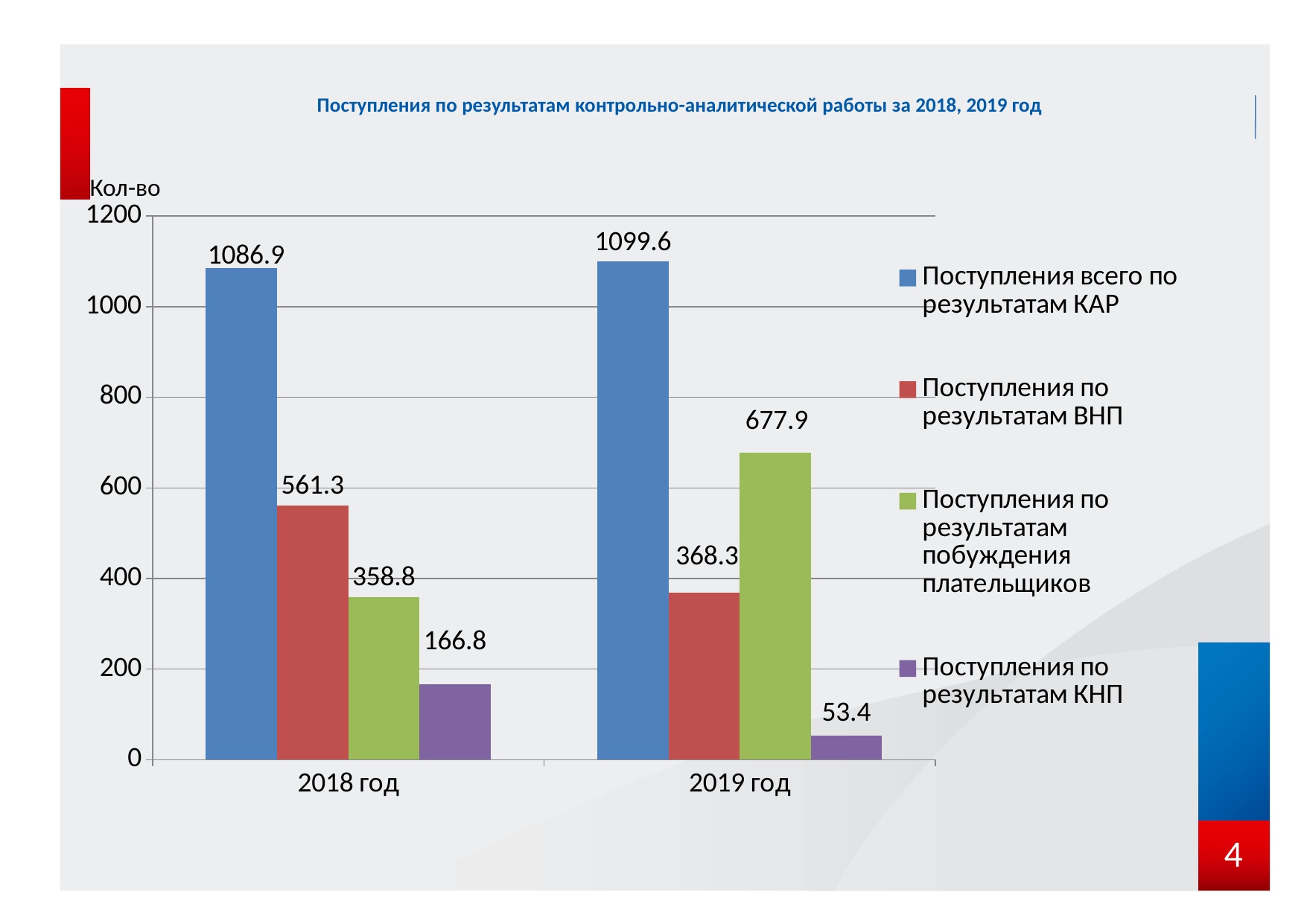
Does "Поступления по результатам КНП" rise or fall from 2018 год to 2019 год? fall What is the difference between "Поступления по результатам побуждения плательщиков" in 2019 год and 2018 год? 319.1 What is the value of "Поступления по результатам КНП" for 2019 год? 53.4 Which series has the highest value in 2019 год? Поступления всего по результатам КАР What is the value of "Поступления по результатам ВНП" for 2019 год? 368.3 How many series does the legend list? 4 What kind of chart is shown on the slide? bar chart Which series has the lowest value in 2018 год? Поступления по результатам КНП Is the value for "Поступления по результатам побуждения плательщиков" in 2019 год greater or less than 600? greater How many year categories are shown on the x axis? 2 Which is larger: "Поступления по результатам ВНП" in 2018 год or in 2019 год? 2018 год What is the value of "Поступления всего по результатам КАР" for 2018 год? 1086.9